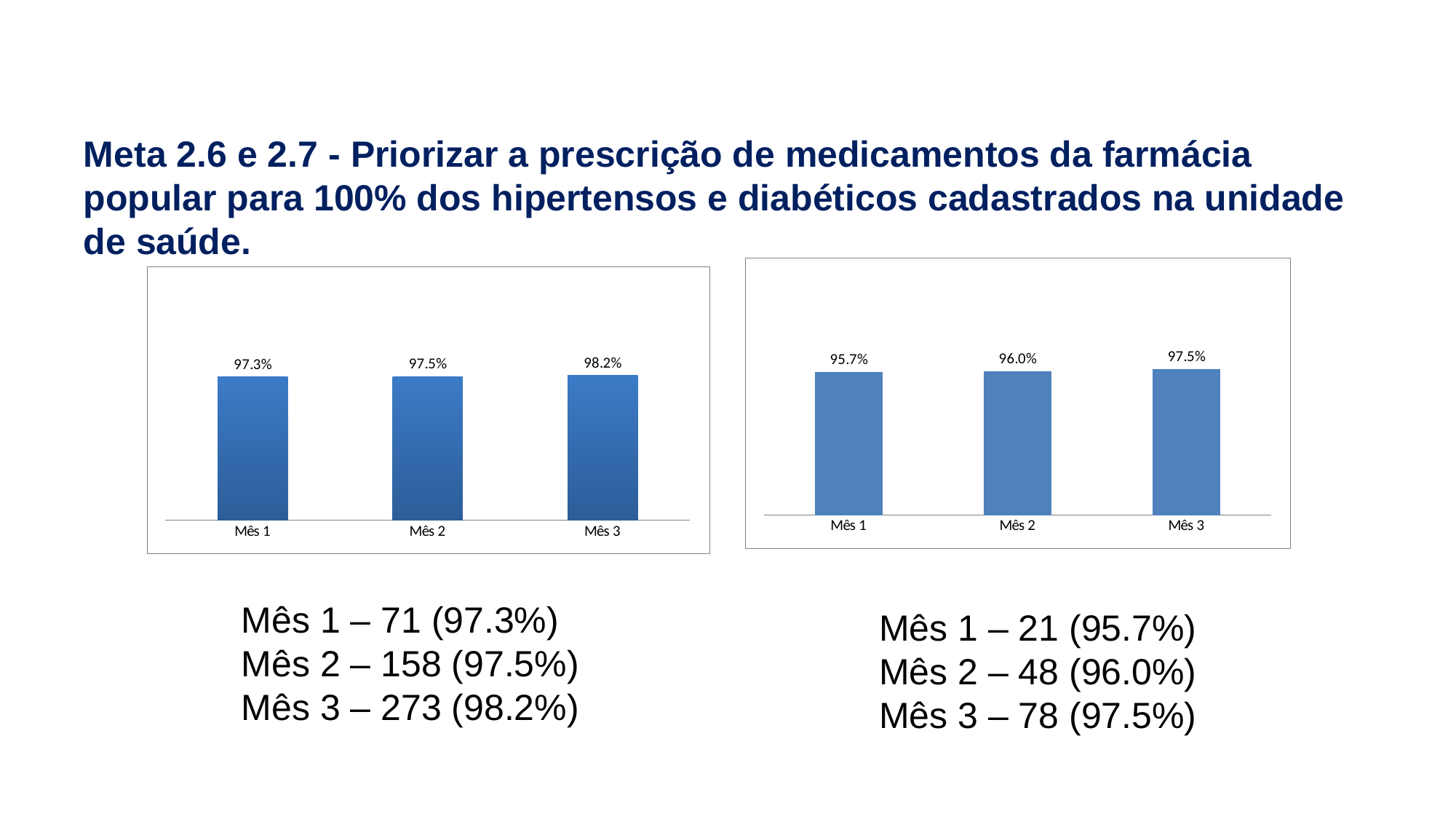
In the right chart, what is the value for Mês 2? 96.0% In the left chart, what is the value for Mês 1? 97.3% How many bars does the left chart have? 3 In the right chart, which month has the lowest value? Mês 1 In the left chart, do the values rise or fall from Mês 1 to Mês 3? Rise In the right chart, what is the difference between the values for Mês 3 and Mês 1? 1.8 percentage points In the left chart, which month has the highest value? Mês 3 In the left chart, what is the difference between the values for Mês 3 and Mês 1? 0.9 percentage points In the right chart, which is larger, the value for Mês 2 or the value for Mês 3? Mês 3 In the right chart, what is the value for Mês 3? 97.5% What kind of chart is the right chart? Bar chart In the left chart, what is the value for Mês 3? 98.2%